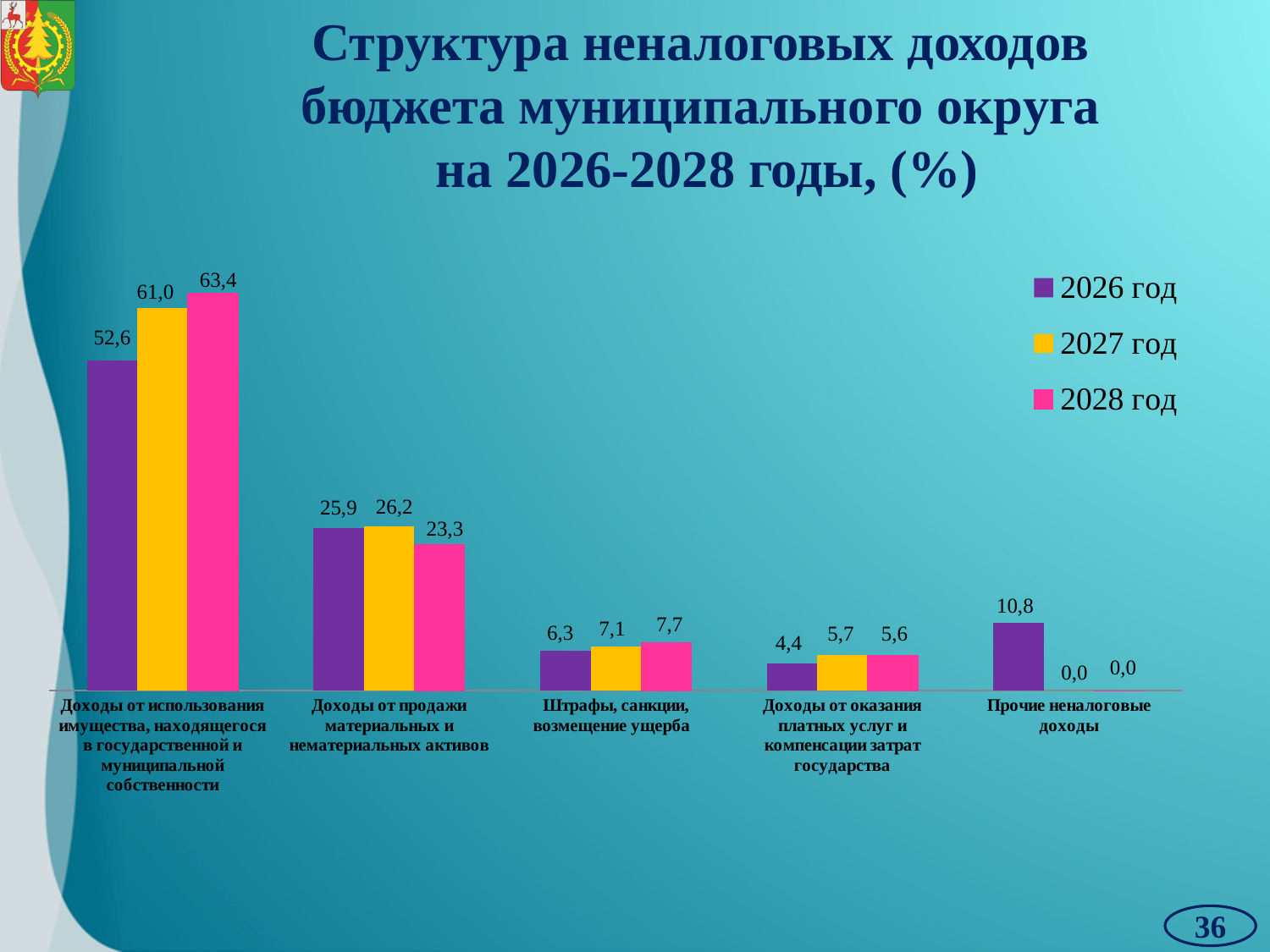
What is the value for 2026 год in the category «Доходы от использования имущества, находящегося в государственной и муниципальной собственности»? 52,6 What kind of chart is shown on the slide? Bar chart Which category has the highest value for 2028 год? Доходы от использования имущества, находящегося в государственной и муниципальной собственности What is the value for 2027 год in the category «Штрафы, санкции, возмещение ущерба»? 7,1 Which is larger for «Доходы от продажи материальных и нематериальных активов»: the value for 2027 год or for 2028 год? 2027 год What is the difference between the 2028 год and 2026 год values for «Доходы от использования имущества, находящегося в государственной и муниципальной собственности»? 10,8 Do the values for «Штрафы, санкции, возмещение ущерба» rise or fall from 2026 год to 2028 год? Rise Which category has the lowest value for 2027 год? Прочие неналоговые доходы What is the value for 2028 год in the category «Доходы от продажи материальных и нематериальных активов»? 23,3 What is the value for 2026 год in the category «Прочие неналоговые доходы»? 10,8 How many series does the legend list? 3 How many categories are shown on the x axis of the chart? 5